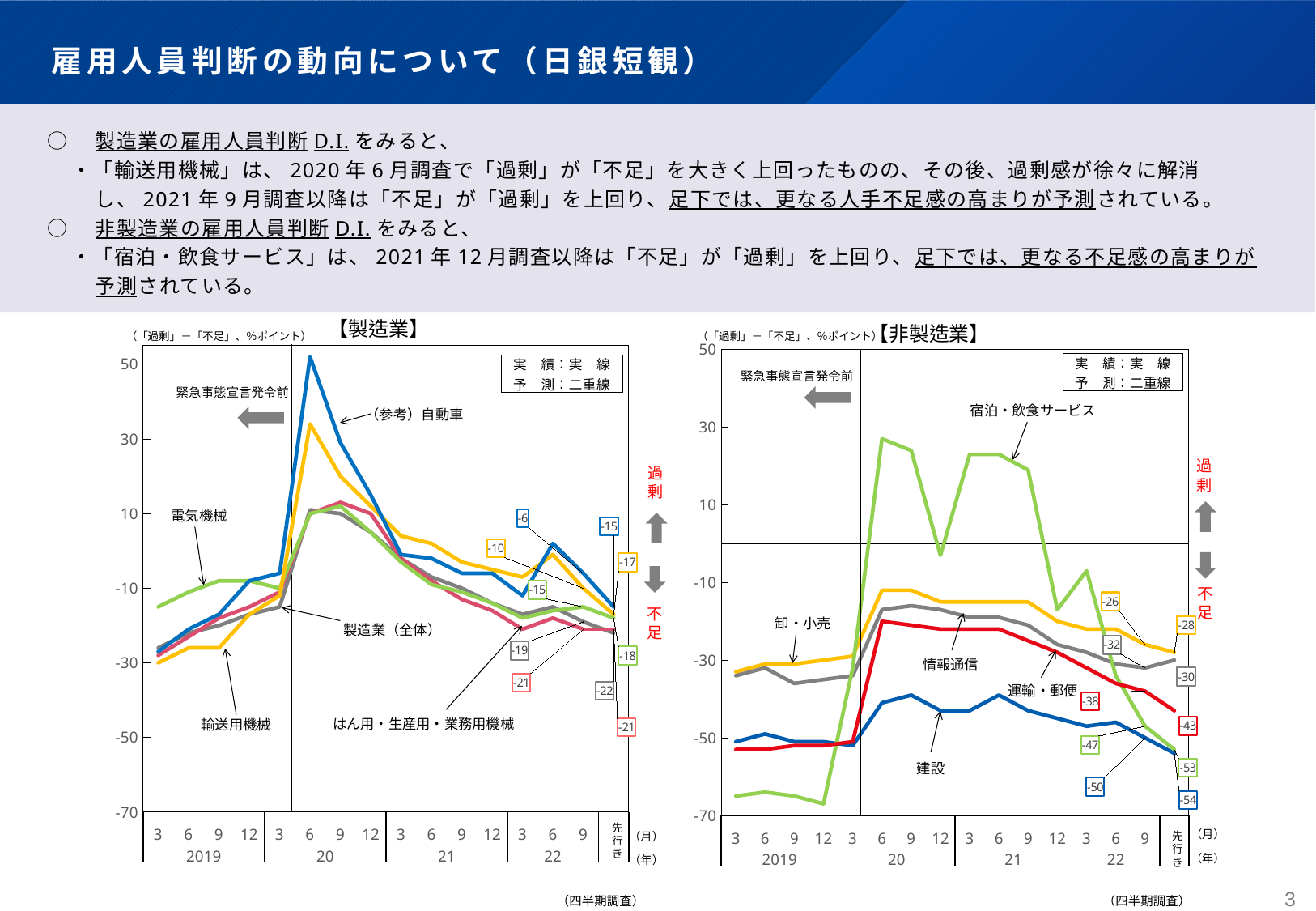
What kind of chart is the 【製造業】 chart? line chart In the 【非製造業】 chart, what is the 先行き (forecast) value for 宿泊・飲食サービス? -53 In the 【非製造業】 chart, what is the value for 建設 in the 2022年9月 survey? -50 How many series (lines) are plotted in the 【非製造業】 chart? 5 In the 【製造業】 chart, is the value for （参考）自動車 in the 2020年6月 survey greater or less than 30? greater In the 【製造業】 chart, what is the value for 輸送用機械 in the 2022年9月 survey? -10 In the 【製造業】 chart, what is the 先行き (forecast) value for （参考）自動車? -15 In the 【製造業】 chart, which series has the lowest value in the 2022年9月 survey? はん用・生産用・業務用機械 In the 【非製造業】 chart, which series has the highest 先行き value? 卸・小売 In the 【非製造業】 chart, what is the difference between the 先行き values for 卸・小売 (-28) and 建設 (-54)? 26 In the 【製造業】 chart, which has the higher 先行き value: 電気機械 or 製造業（全体）? 電気機械 In the 【非製造業】 chart, does the 宿泊・飲食サービス line rise or fall from the 2022年3月 survey to 先行き? fall